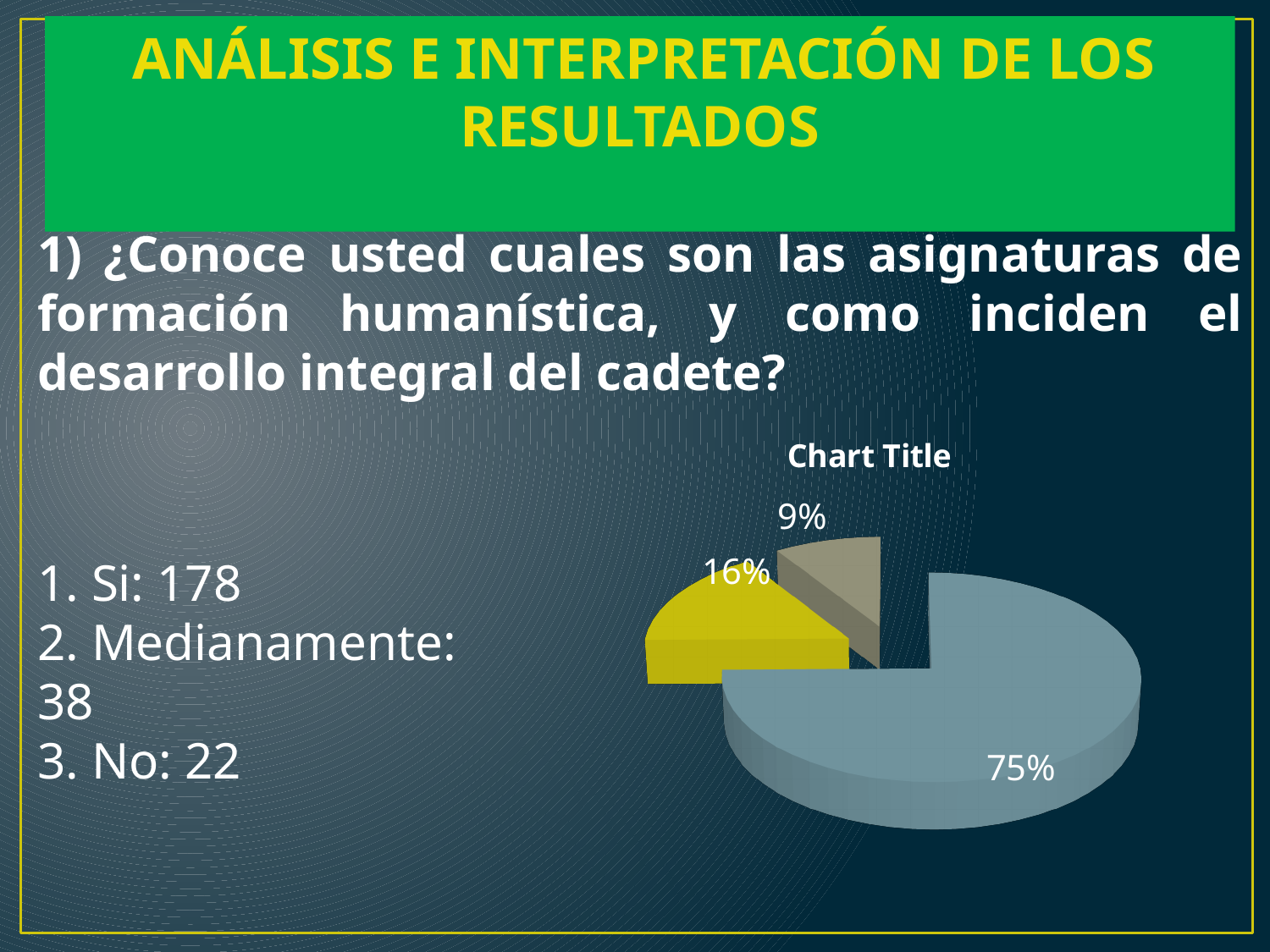
What is the title shown above the pie chart? Chart Title What percentage is shown on the largest slice of the pie chart? 75% What is the difference in percentage points between the largest slice and the yellow slice? 59% What is the difference in percentage points between the yellow slice and the grey-brown slice? 7% What kind of chart is shown on the slide? pie chart What percentage is shown on the smallest slice of the pie chart? 9% What value is labelled on the grey-brown slice of the pie chart? 9% What value is labelled on the blue slice of the pie chart? 75% Which slice is larger, the yellow slice or the grey-brown slice? the yellow slice What value is labelled on the yellow slice of the pie chart? 16% How many slices does the pie chart have? 3 Does the pie chart display a legend? No